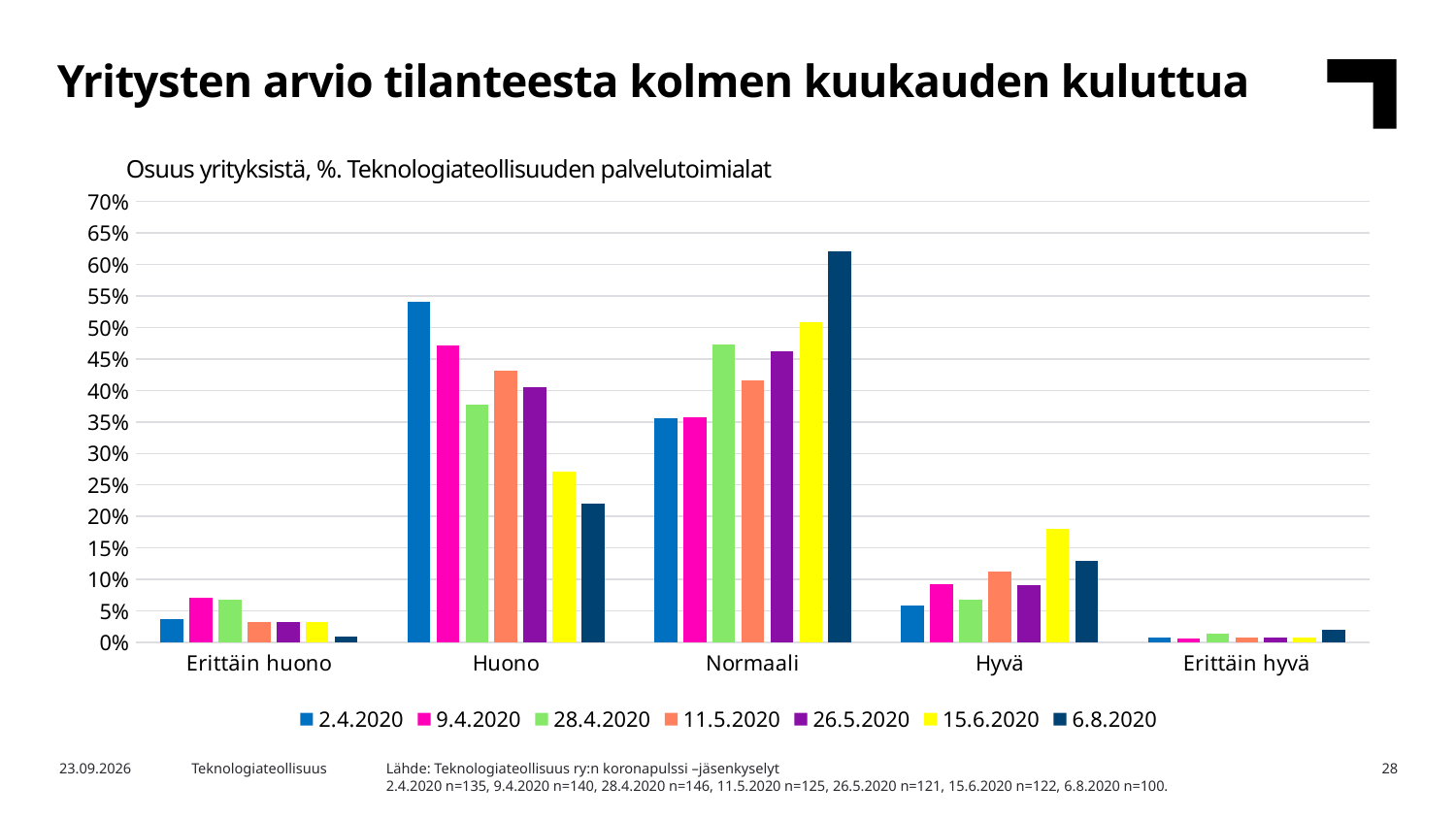
What kind of chart is shown on the slide? bar chart Is the value for Normaali in the 6.8.2020 series greater or less than 60%? greater Is the value for Huono in the 2.4.2020 series greater or less than 50%? greater Within the Hyvä category, which series has the highest value? 15.6.2020 In the 2.4.2020 series, which is larger: the value for Huono or the value for Normaali? Huono How many categories are shown on the x axis? 5 What is the subtitle shown above the chart? Osuus yrityksistä, %. Teknologiateollisuuden palvelutoimialat Is the value for Hyvä in the 15.6.2020 series greater or less than 15%? greater Within the Normaali category, which series has the highest value? 6.8.2020 Within the Huono category, which series has the highest value? 2.4.2020 How many series does the legend list? 7